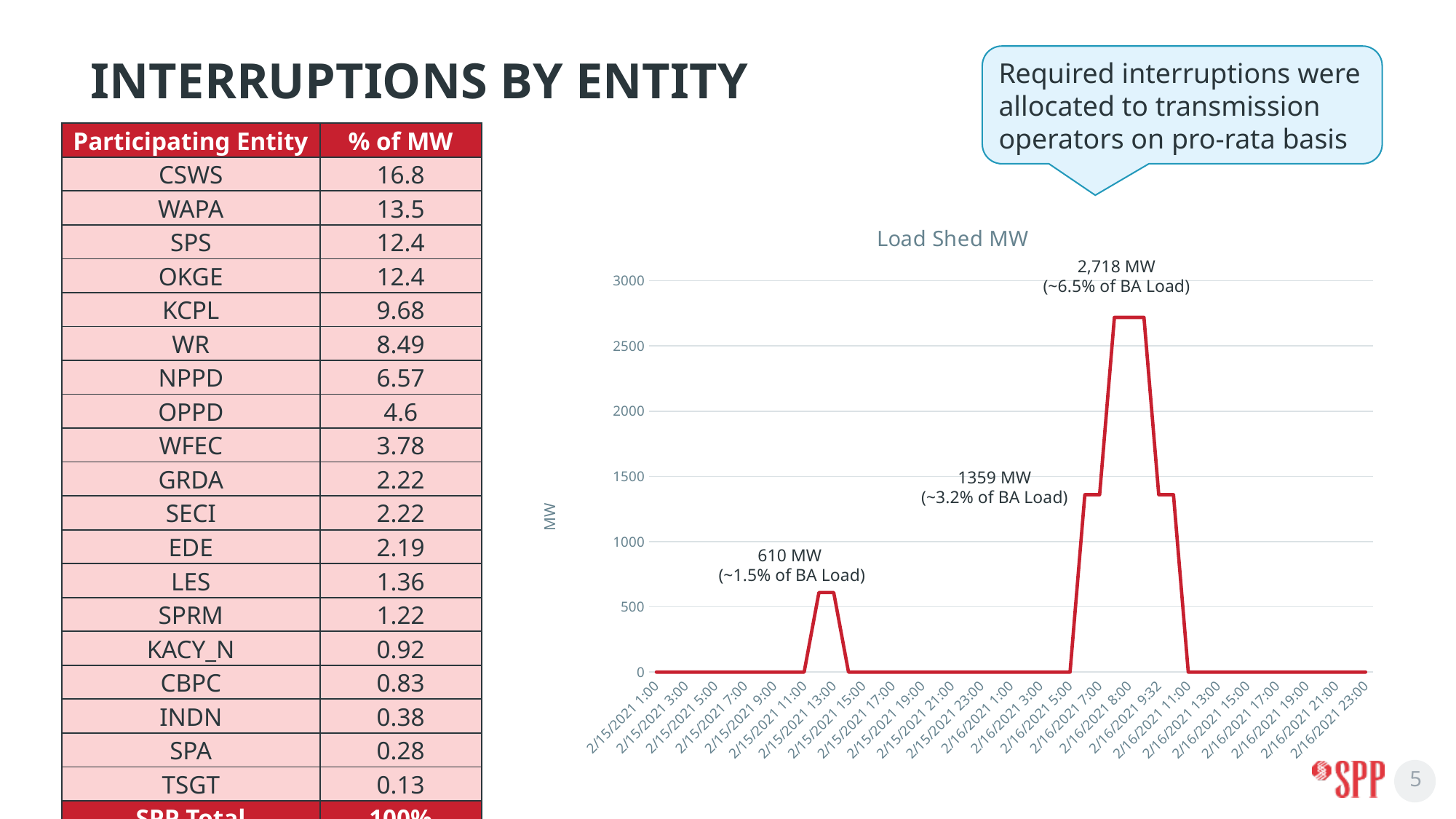
In the Load Shed MW chart, what is the highest load shed value labelled on the line? 2,718 MW In the Load Shed MW chart, do the values rise or fall between 2/16/2021 9:32 and 2/16/2021 11:00? fall In the Load Shed MW chart, is the value at 2/16/2021 8:00 greater or less than 2500? greater In the Load Shed MW chart, which day has the larger load shed peak, 2/15/2021 or 2/16/2021? 2/16/2021 In the Load Shed MW chart, what is the label on the vertical axis? MW In the Load Shed MW chart, what is the difference between the 2,718 MW peak and the 1359 MW level? 1,359 MW In the Load Shed MW chart, what is the difference between the 2,718 MW peak and the 610 MW peak? 2,108 MW In the Load Shed MW chart, what is the load shed value at 2/15/2021 1:00? 0 In the Load Shed MW chart, is the value at 2/15/2021 13:00 greater or less than 1000? less In the Load Shed MW chart, what percentage of BA Load does the 610 MW load shed represent according to the annotation? ~1.5% What is the title of the chart on the right of the slide? Load Shed MW What type of chart is the Load Shed MW chart? line chart